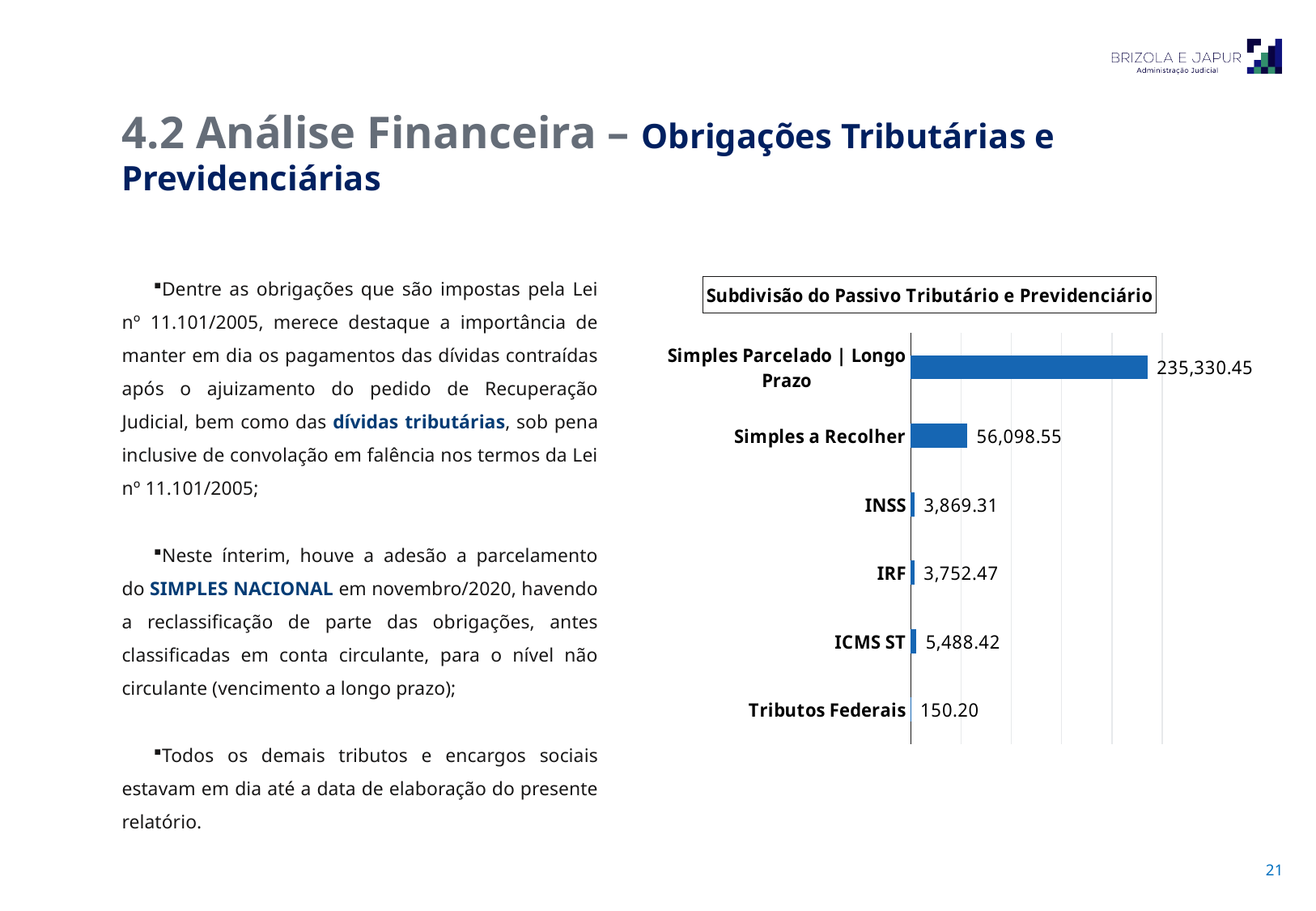
How many categories are shown in the chart? 6 What is the value for Tributos Federais? 150.20 What is the value for Simples a Recolher? 56,098.55 What is the difference between Simples Parcelado | Longo Prazo and Simples a Recolher? 179,231.90 Which is larger, INSS or IRF? INSS What is the value for Simples Parcelado | Longo Prazo? 235,330.45 Which category has the lowest value? Tributos Federais Which category has the highest value? Simples Parcelado | Longo Prazo What is the difference between ICMS ST and INSS? 1,619.11 What is the title of the chart? Subdivisão do Passivo Tributário e Previdenciário What is the value for ICMS ST? 5,488.42 What kind of chart is shown on the slide? Bar chart